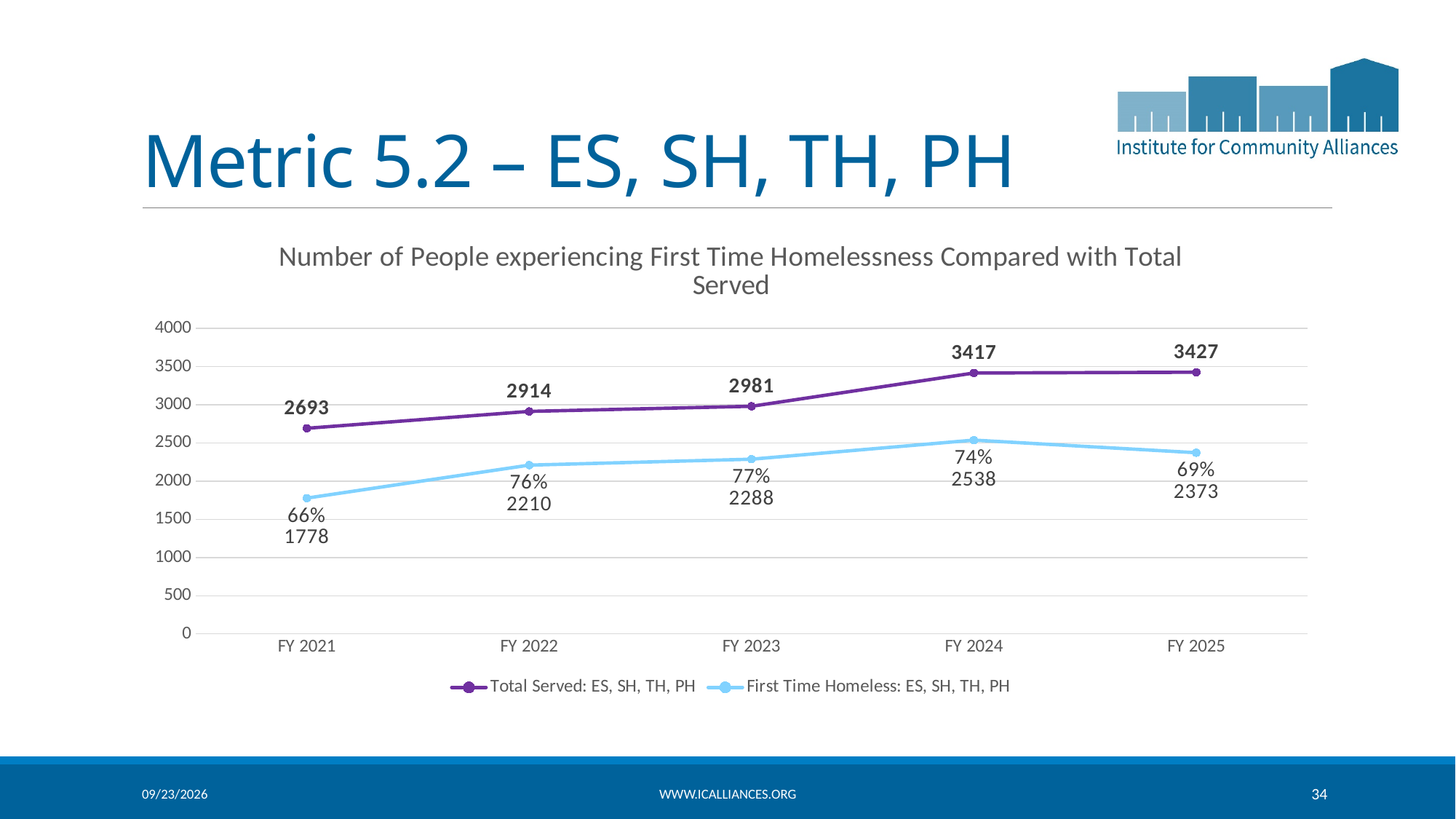
What kind of chart is shown on the slide? Line chart Does Total Served: ES, SH, TH, PH rise or fall from FY 2021 to FY 2025? Rise What percentage is shown for First Time Homeless: ES, SH, TH, PH in FY 2021? 66% In which fiscal year is Total Served: ES, SH, TH, PH highest? FY 2025 Is the value for Total Served: ES, SH, TH, PH in FY 2021 greater or less than 2500? greater How many fiscal years are shown on the x axis? 5 What is the difference between Total Served and First Time Homeless in FY 2022? 704 In which fiscal year is First Time Homeless: ES, SH, TH, PH lowest? FY 2021 How many series does the legend list? 2 What is the value for Total Served: ES, SH, TH, PH in FY 2023? 2981 Which is larger: First Time Homeless in FY 2024 or First Time Homeless in FY 2025? FY 2024 What is the number of First Time Homeless: ES, SH, TH, PH in FY 2024? 2538